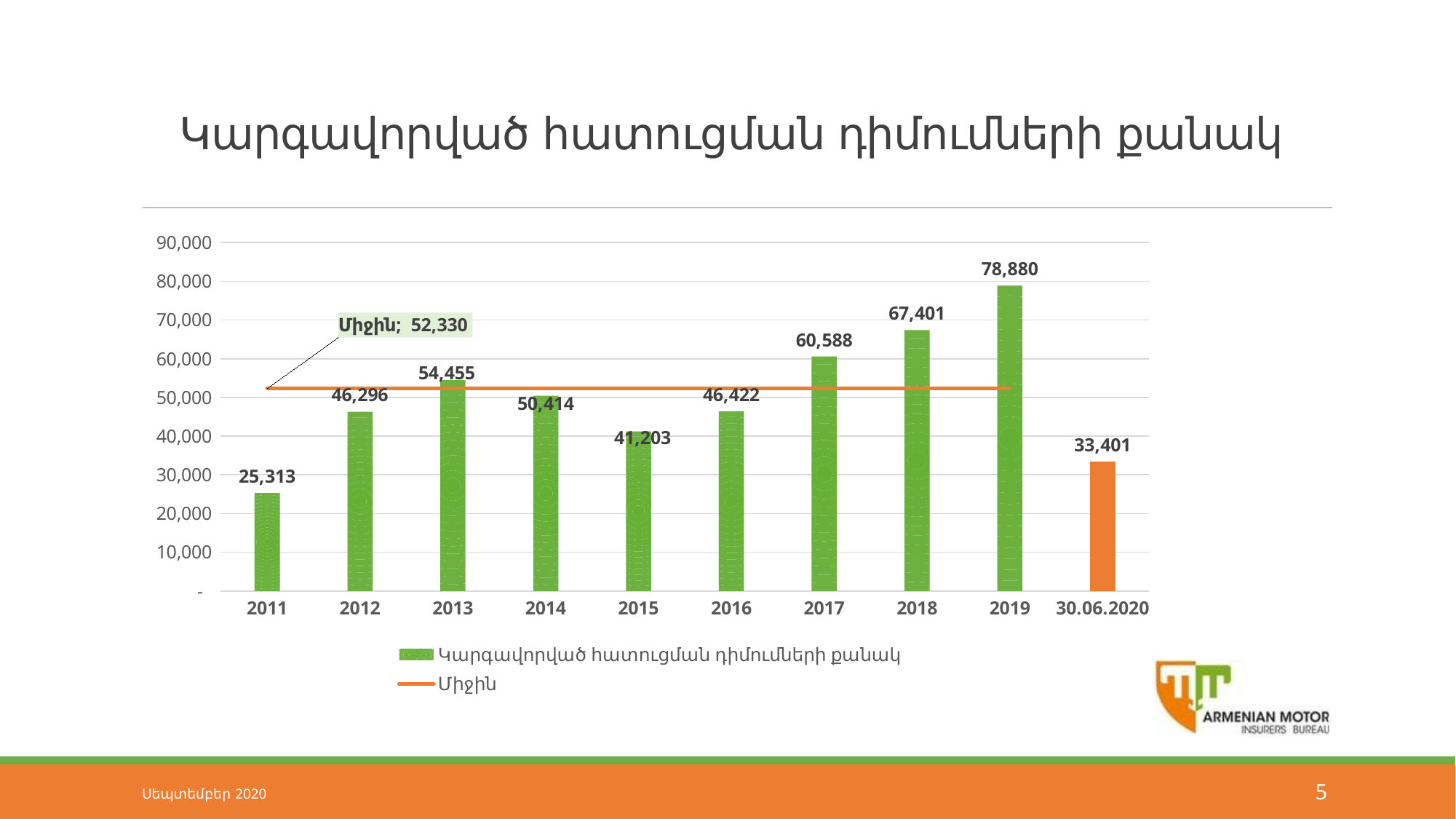
How many categories are shown on the x axis? 10 What is the value for 2019? 78,880 What is the difference between the values for 2019 and 2018? 11,479 What kind of chart is shown on the slide? combination bar and line chart (bars with an average line) What is the value of the average (Միջին) line? 52,330 What is the value shown for 30.06.2020? 33,401 Which category has the lowest bar? 2011 How many entries does the legend list? 2 What is the value for 2011? 25,313 Which is larger, the value for 2013 or the value for 2014? 2013 Which year has the highest bar? 2019 Is the value for 2017 greater or less than 60,000? greater